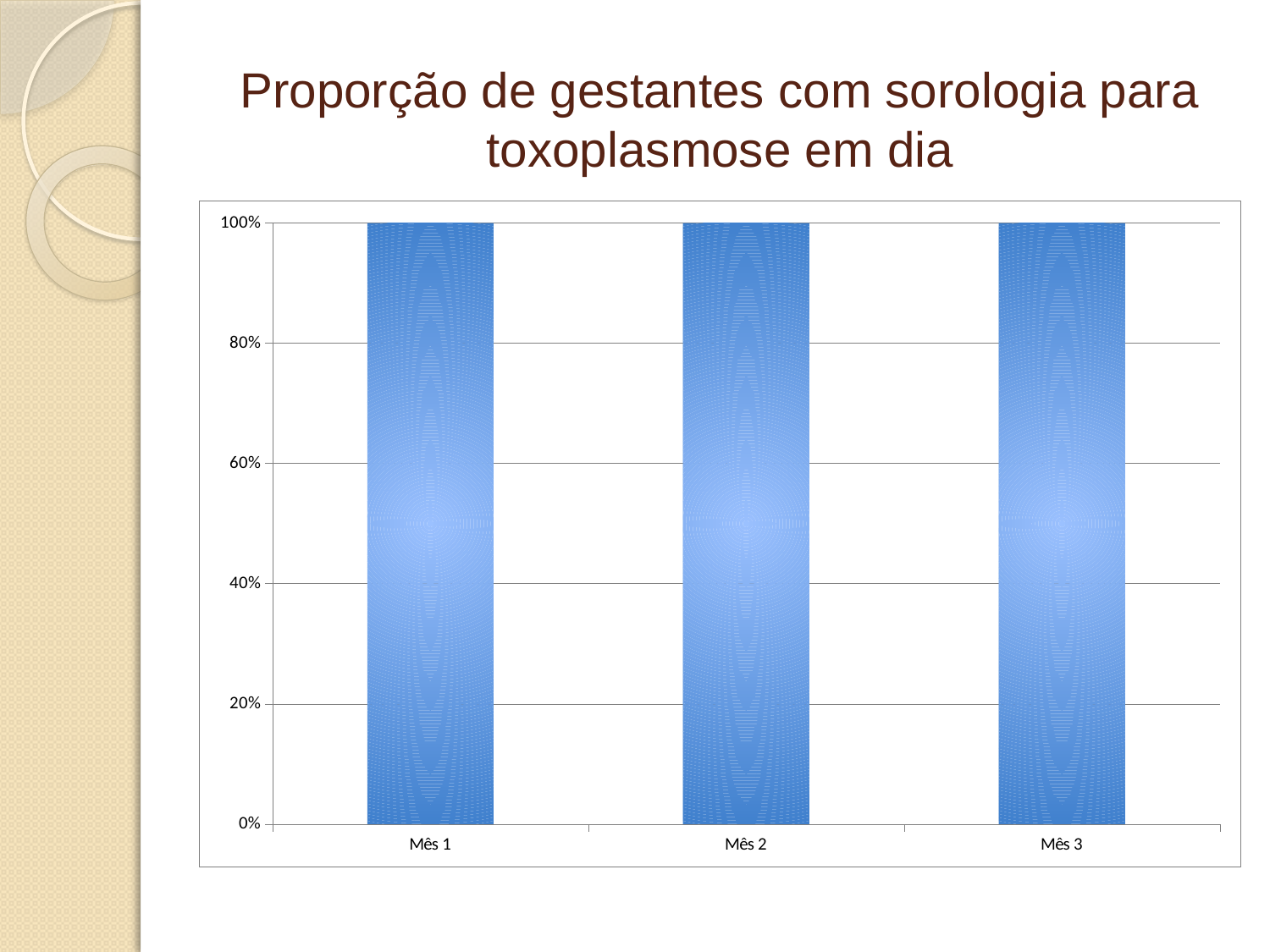
What is the label of the first category on the x axis? Mês 1 What is the difference between the values for Mês 1 and Mês 3? 0% Is the value for Mês 3 greater or less than 60%? greater How many categories are plotted on the x axis of the chart? 3 What is the highest value shown on the y axis? 100% What is the value for Mês 3? 100% Is the value for Mês 2 greater or less than 80%? greater What type of chart is shown on the slide? bar chart What is the value for Mês 1? 100%